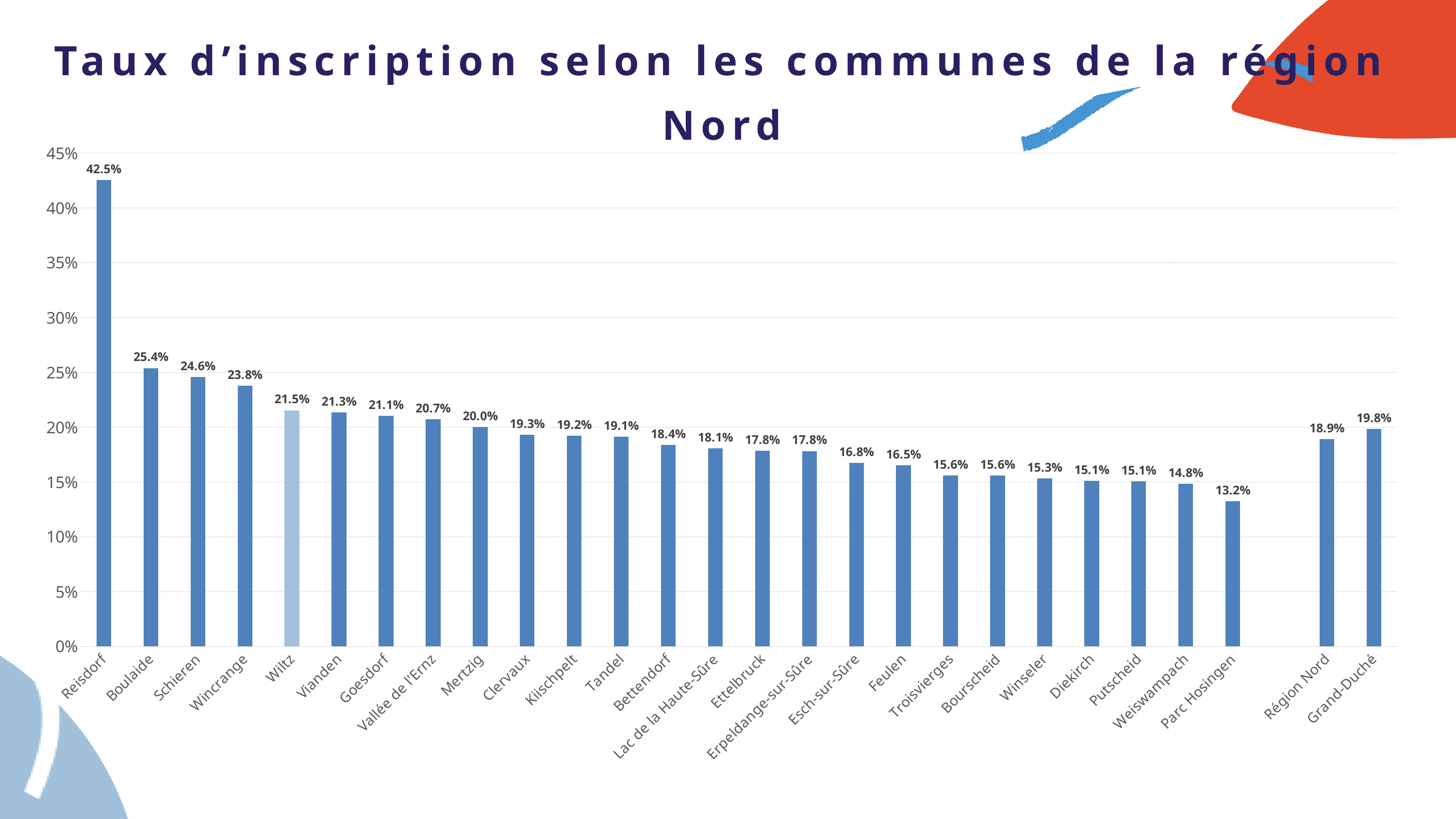
Is the value for Parc Hosingen greater or less than 15%? less What is the difference between the values for Reisdorf and Boulaide? 17.1% Which is larger, the value for Diekirch or the value for Ettelbruck? Ettelbruck What kind of chart is shown on the slide? bar chart Which commune has the lowest value? Parc Hosingen Which bar is shown in a lighter blue colour than the others? Wiltz What is the value for Région Nord? 18.9% What is the value for Wiltz? 21.5% Which commune has the highest value? Reisdorf How many bars are shown in the chart? 27 What is the value for Reisdorf? 42.5% What is the value for Grand-Duché? 19.8%